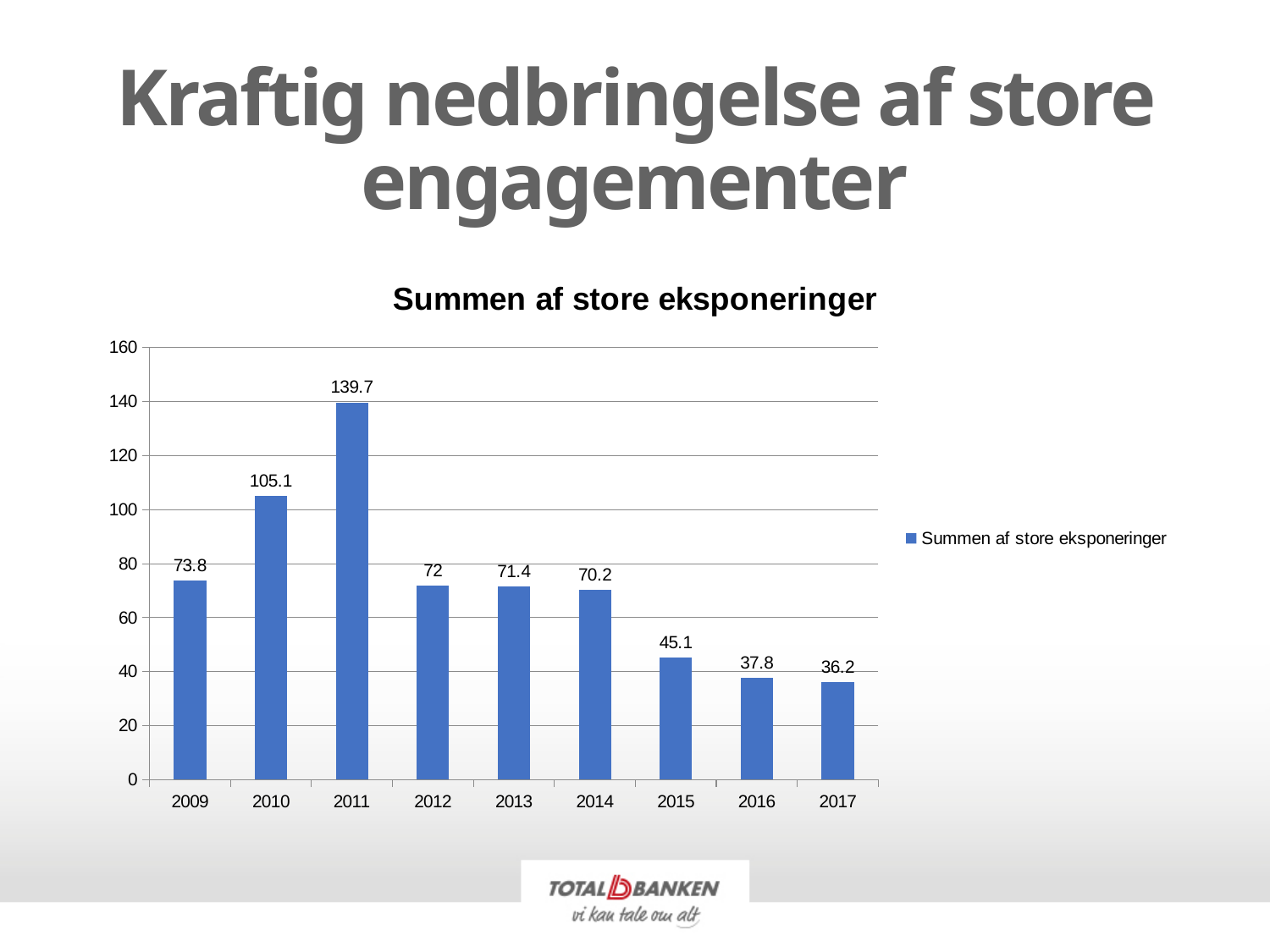
Which year has the highest value? 2011 Which is larger, the value for 2009 or the value for 2014? 2009 What is the title of the chart? Summen af store eksponeringer Which year has the lowest value? 2017 What is the difference between the values for 2015 and 2016? 7.3 What is the value for 2013? 71.4 How many years are shown on the x axis? 9 What kind of chart is this? bar chart What is the value for 2017? 36.2 What is the value for 2011? 139.7 What is the difference between the values for 2011 and 2010? 34.6 Is the value for 2010 greater or less than 100? greater